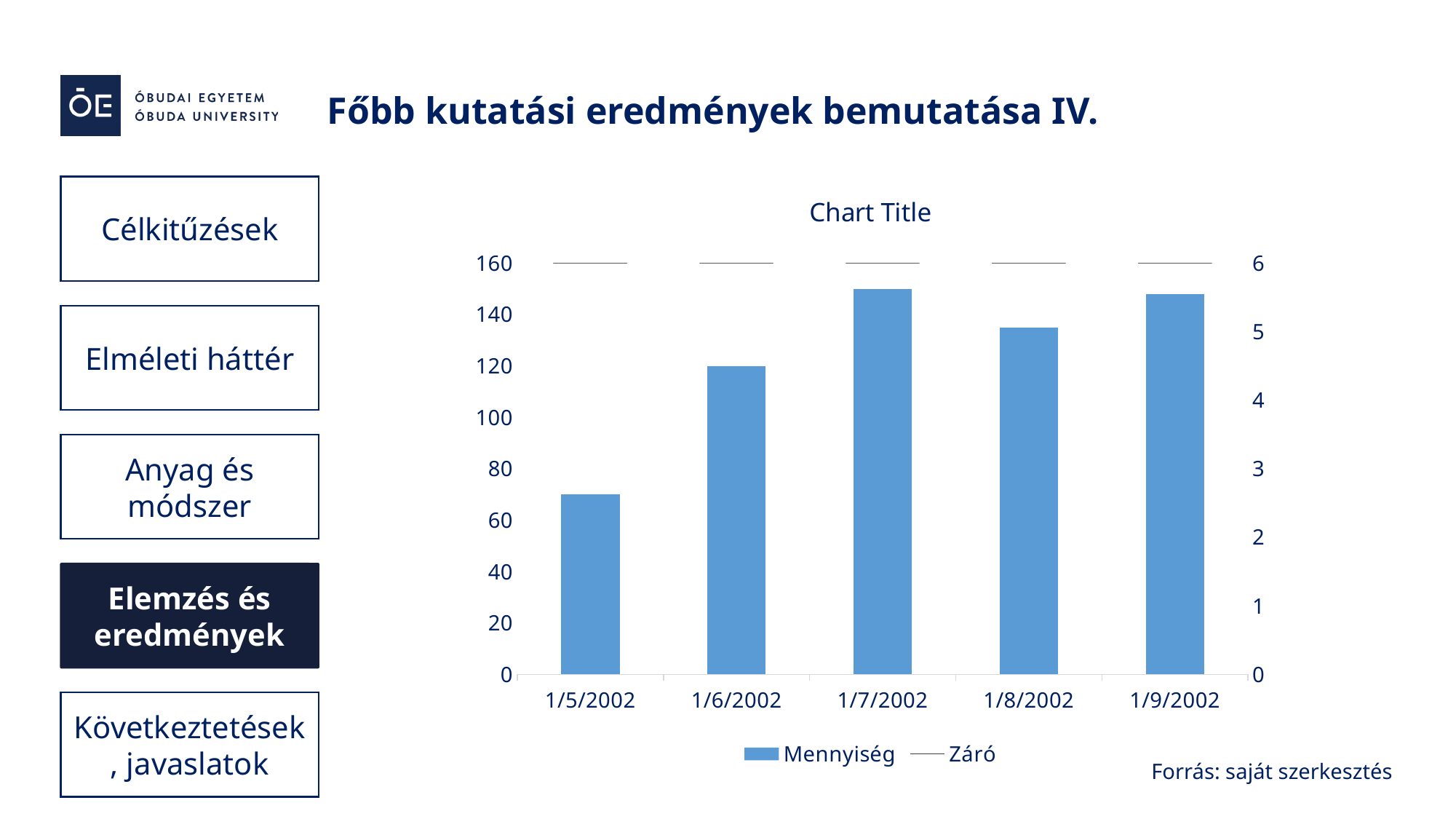
What kind of chart is shown on the slide? bar chart Is the Mennyiség value for 1/8/2002 greater or less than 120? greater How many series does the chart legend list? 2 Which date has the lowest Mennyiség value? 1/5/2002 What are the two series named in the chart legend? Mennyiség and Záró Which has the larger Mennyiség value, 1/6/2002 or 1/8/2002? 1/8/2002 Is the Mennyiség value for 1/7/2002 greater or less than 140? greater What is the title of the chart? Chart Title Is the Mennyiség value for 1/5/2002 greater or less than 80? less How many dates are shown on the x axis of the chart? 5 What is the Mennyiség value for 1/6/2002? 120 Do the Mennyiség values rise or fall from 1/5/2002 to 1/7/2002? rise